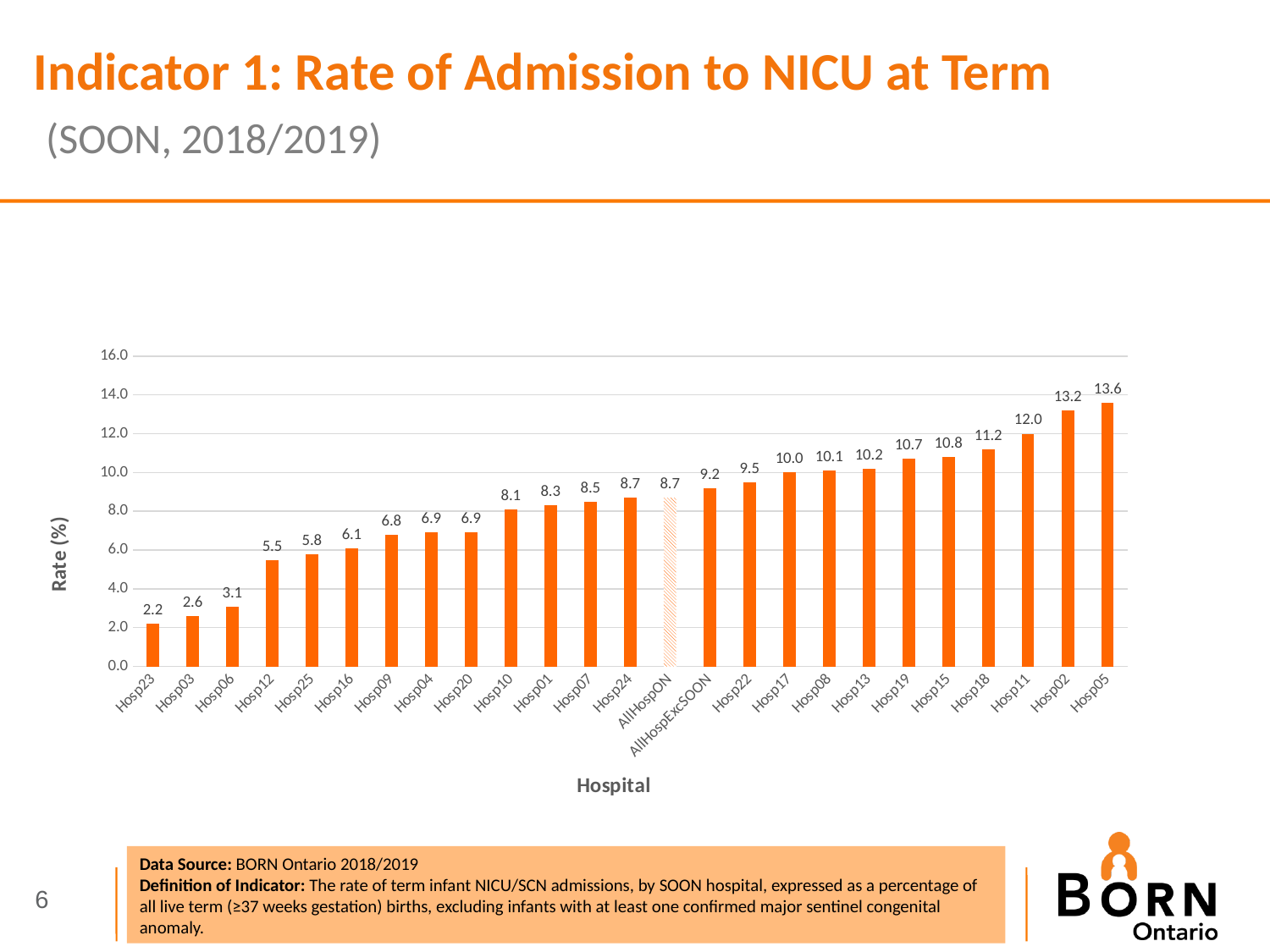
What is the value shown for AllHospExcSOON? 9.2 Which hospital has the highest rate of admission to NICU at term? Hosp05 Which hospital has the lowest rate of admission to NICU at term? Hosp23 What is the rate for Hosp18? 11.2 Which has a higher rate, Hosp09 or Hosp13? Hosp13 What is the difference between the rates for Hosp05 and Hosp23? 11.4 What kind of chart is shown on the slide? Bar chart Is the value for Hosp02 greater or less than 12.0? greater What is the difference between the rates for Hosp11 and Hosp22? 2.5 What is the label of the y-axis? Rate (%) What is the rate of admission to NICU at term for Hosp12? 5.5 How many bars are plotted in the chart? 25